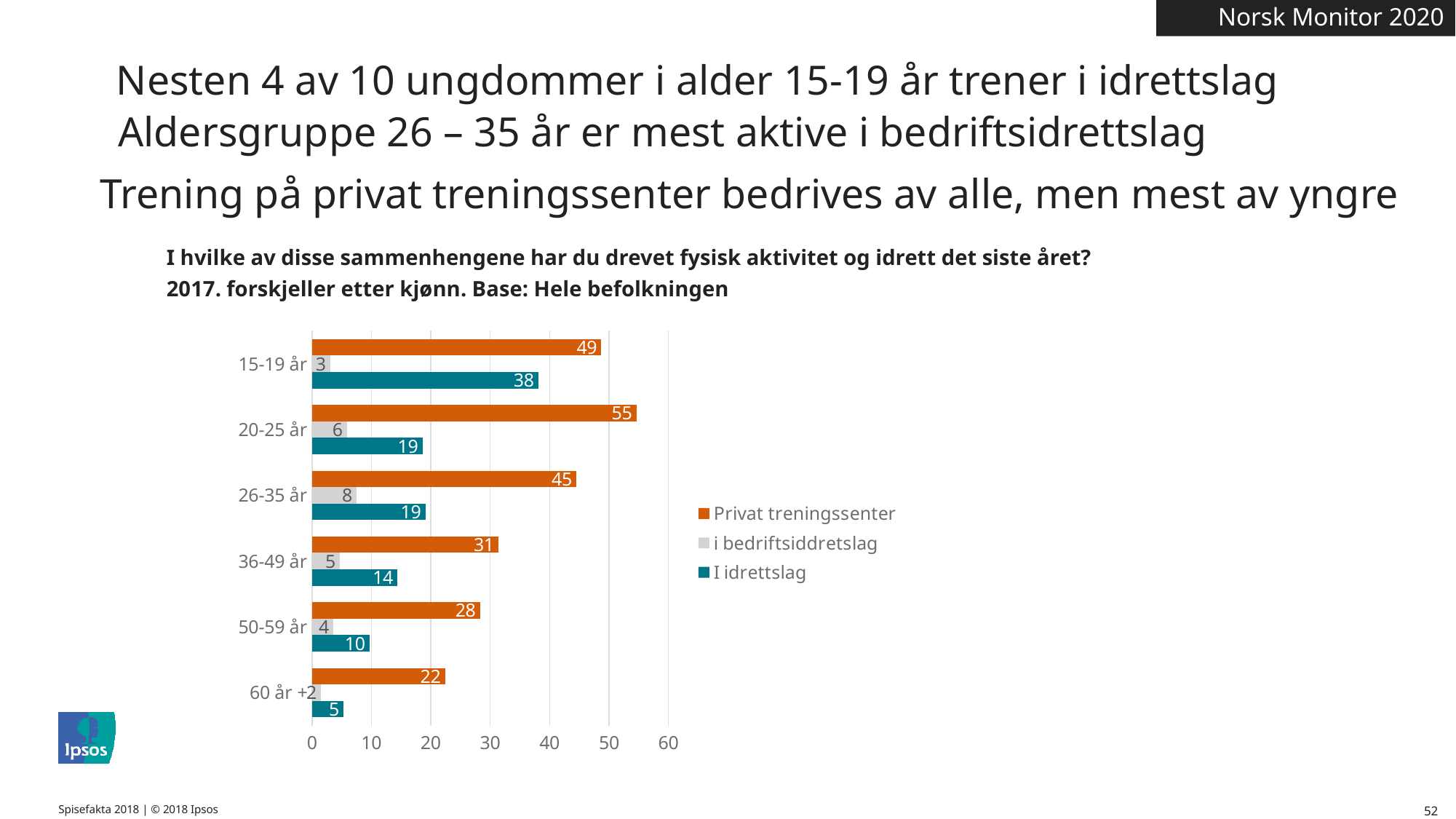
Which age group has the highest value for 'Privat treningssenter'? 20-25 år How many series does the legend list? 3 How many age groups are shown on the chart? 6 Do the 'I idrettslag' values rise or fall as the age groups get older? Fall What is the difference between the 'Privat treningssenter' values for 15-19 år and 60 år +? 27 What kind of chart is shown on the slide? Bar chart Which is larger: 'I idrettslag' for 36-49 år or 'I idrettslag' for 50-59 år? 36-49 år What is the value for 'i bedriftsiddretslag' in the 26-35 år age group? 8 What is the value for 'Privat treningssenter' in the 20-25 år age group? 55 Which colour represents 'I idrettslag' in the legend? Teal (blue-green) Which age group has the lowest value for 'I idrettslag'? 60 år + What is the value for 'I idrettslag' in the 15-19 år age group? 38